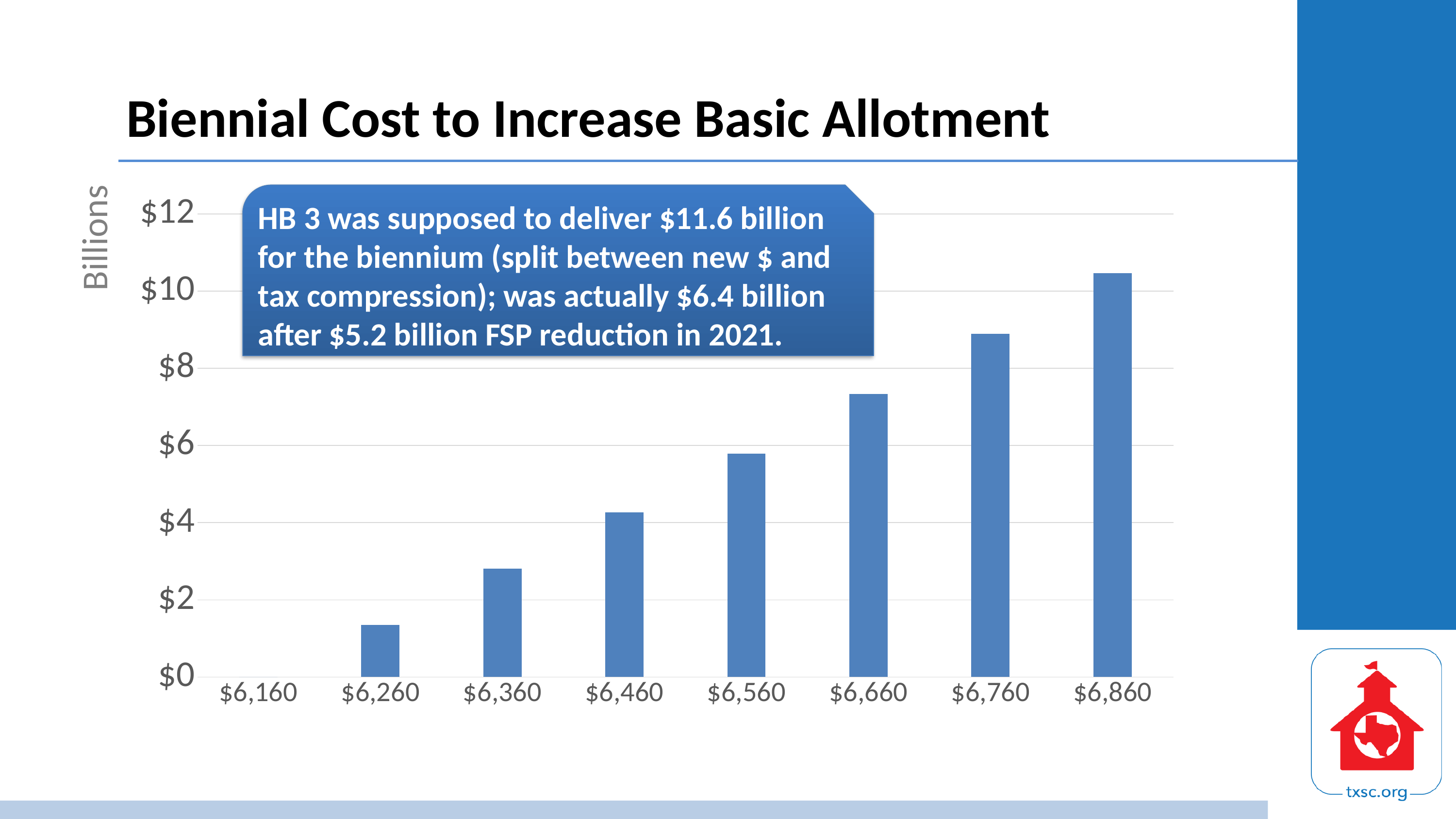
Which has the larger biennial cost, $6,460 or $6,660? $6,660 Is the biennial cost for $6,260 greater or less than $2 billion? less Is the biennial cost for $6,860 greater or less than $10 billion? greater What is the title of the chart? Biennial Cost to Increase Basic Allotment What kind of chart is shown on the slide? bar chart Which basic allotment level has the highest biennial cost? $6,860 Is the biennial cost for $6,560 greater or less than $6 billion? less Which basic allotment level has the lowest biennial cost? $6,160 How many basic allotment categories are shown on the x axis? 8 Do the biennial costs rise or fall as the basic allotment increases along the x axis? rise What is the label on the vertical axis of the chart? Billions